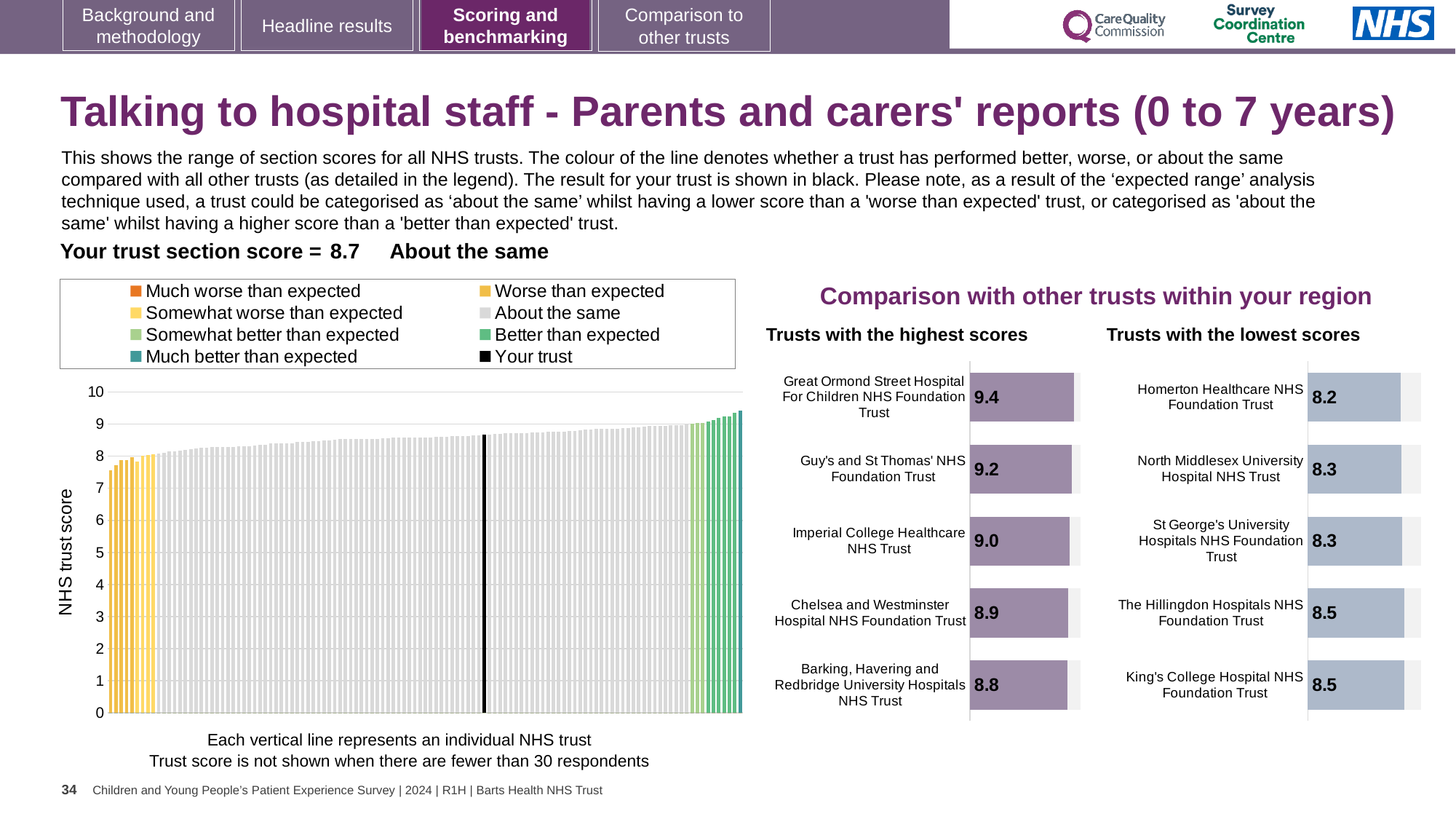
In the 'Trusts with the lowest scores' chart, what is the score for The Hillingdon Hospitals NHS Foundation Trust? 8.5 What is the y-axis label of the large chart on the left? NHS trust score In the 'Trusts with the lowest scores' chart, which has the larger score: Homerton Healthcare NHS Foundation Trust or North Middlesex University Hospital NHS Trust? North Middlesex University Hospital NHS Trust In the 'Trusts with the highest scores' chart, what is the score for Imperial College Healthcare NHS Trust? 9.0 In the large chart on the left, is the value for the black 'Your trust' line greater or less than 8? greater In the 'Trusts with the highest scores' chart, which trust has the lowest score? Barking, Havering and Redbridge University Hospitals NHS Trust In the 'Trusts with the lowest scores' chart, which trust has the lowest score? Homerton Healthcare NHS Foundation Trust How many entries does the legend of the large chart on the left list? 8 In the 'Trusts with the lowest scores' chart, what is the score for Homerton Healthcare NHS Foundation Trust? 8.2 How many trusts are shown in the 'Trusts with the highest scores' chart? 5 In the 'Trusts with the highest scores' chart, what is the score for Great Ormond Street Hospital For Children NHS Foundation Trust? 9.4 In the 'Trusts with the highest scores' chart, what is the difference between the scores of Great Ormond Street Hospital For Children NHS Foundation Trust and Barking, Havering and Redbridge University Hospitals NHS Trust? 0.6